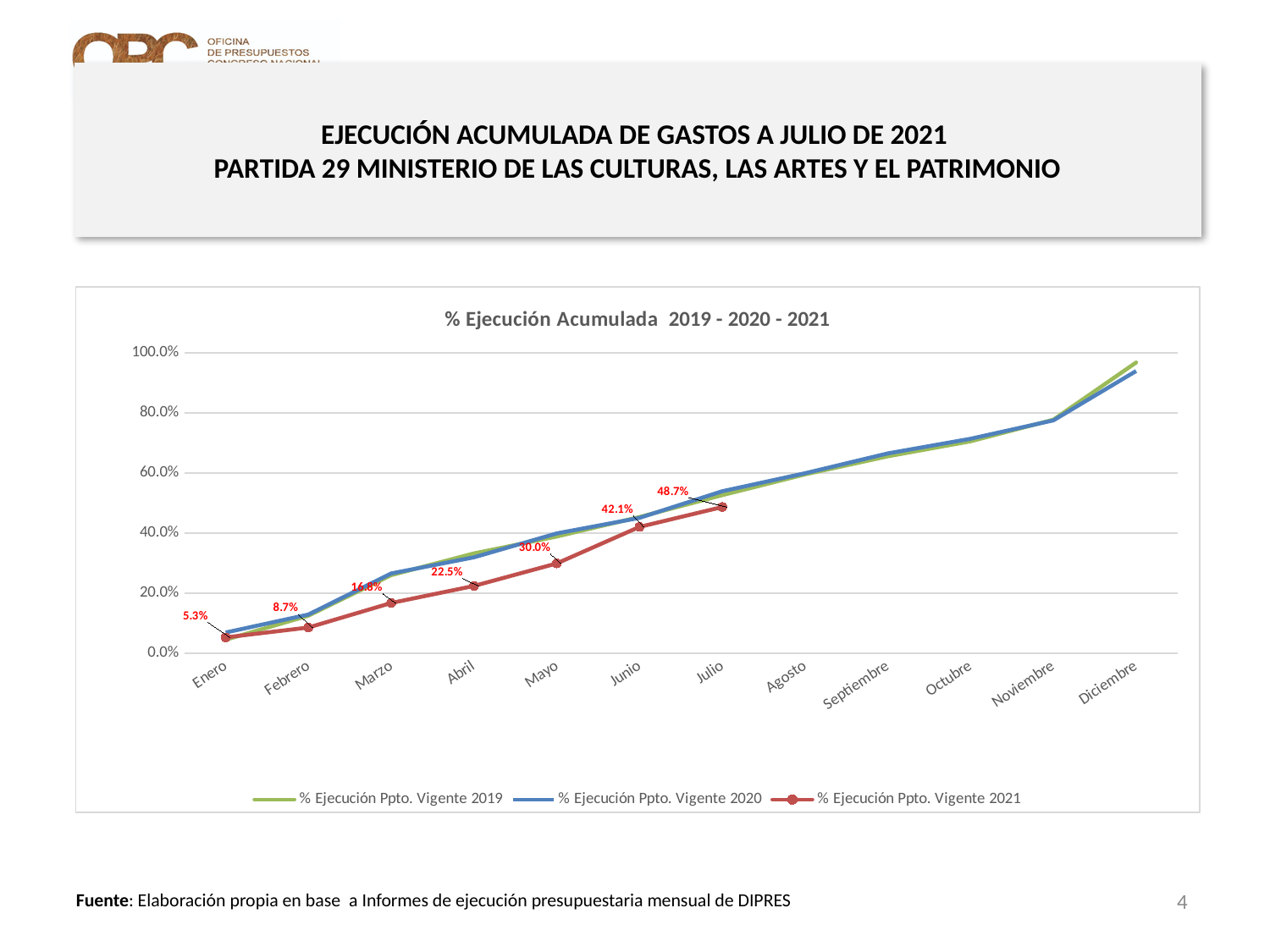
How many months are shown along the x axis of the chart? 12 What is the value for Julio in the % Ejecución Ppto. Vigente 2021 series? 48.7% What is the value for Abril in the % Ejecución Ppto. Vigente 2021 series? 22.5% What kind of chart is shown on the slide? line chart What is the title of the chart? % Ejecución Acumulada 2019 - 2020 - 2021 Which month has the highest value in the % Ejecución Ppto. Vigente 2021 series? Julio How many series does the chart legend list? 3 Is the Diciembre value for % Ejecución Ppto. Vigente 2020 greater or less than 80.0%? greater Do the values of the % Ejecución Ppto. Vigente 2021 series rise or fall from Enero to Julio? rise What is the value for Junio in the % Ejecución Ppto. Vigente 2021 series? 42.1% What is the value for Enero in the % Ejecución Ppto. Vigente 2021 series? 5.3% What is the difference between the Julio and Junio values in the % Ejecución Ppto. Vigente 2021 series? 6.6 percentage points